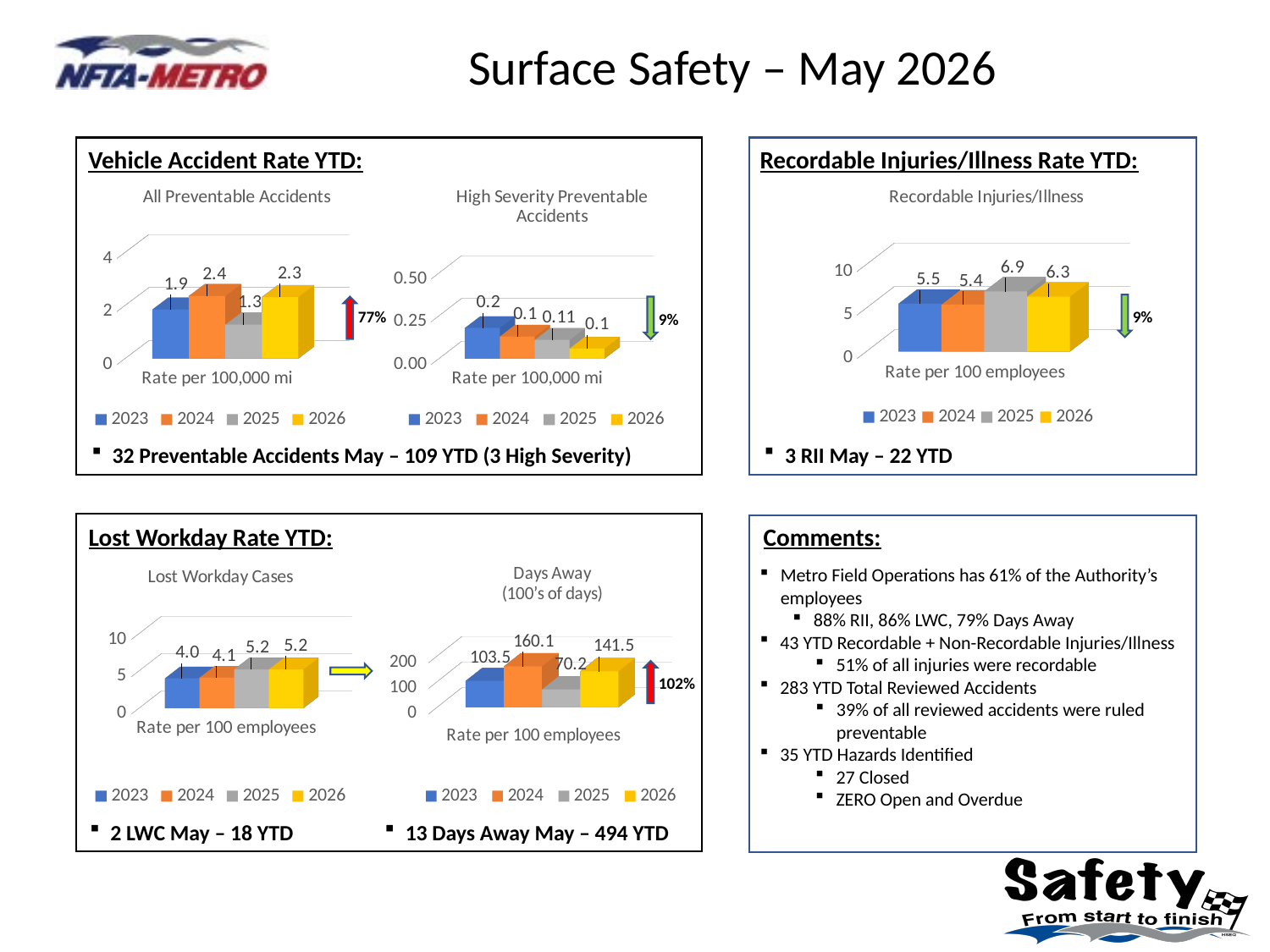
In the Days Away (100's of days) chart, what is the difference between the 2024 and 2026 values? 18.6 In the High Severity Preventable Accidents chart, which year has the highest value? 2023 What kind of chart is the Recordable Injuries/Illness chart? Bar chart In the All Preventable Accidents chart, which year has the lowest value? 2025 In the All Preventable Accidents chart, what is the value for 2026? 2.3 In the Recordable Injuries/Illness chart, which is larger, the value for 2023 or the value for 2026? 2026 In the All Preventable Accidents chart, what is the difference between the 2024 and 2025 values? 1.1 How many series does the legend of the Lost Workday Cases chart list? 4 In the High Severity Preventable Accidents chart, what is the value for 2023? 0.2 In the Days Away (100's of days) chart, which year has the lowest value? 2025 In the Lost Workday Cases chart, what is the value for 2024? 4.1 In the Recordable Injuries/Illness chart, what is the value for 2025? 6.9